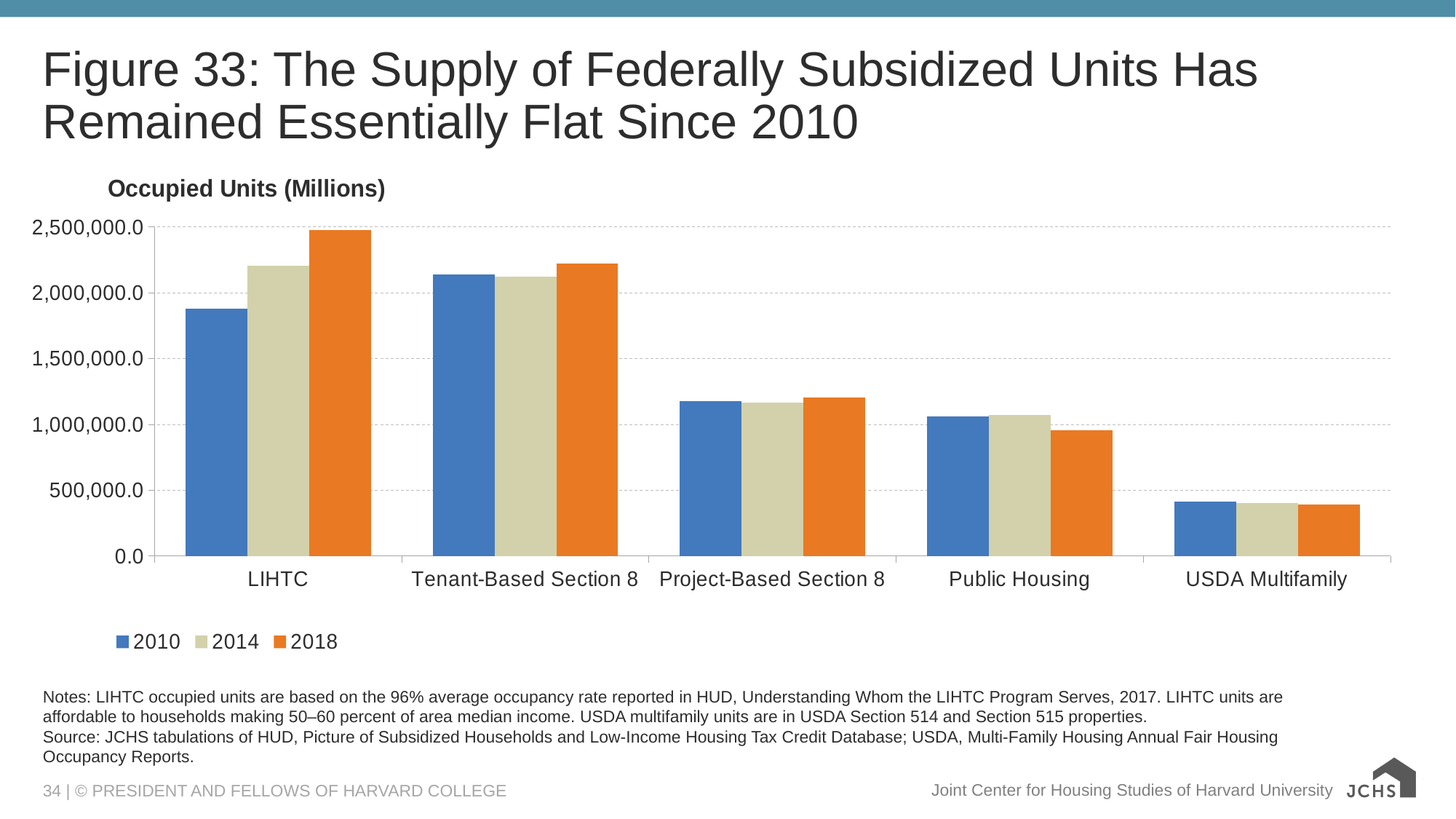
Is the 2010 value for USDA Multifamily greater or less than 500,000.0? less For Public Housing, which year has the larger value: 2010 or 2018? 2010 Which category has the lowest value for 2010? USDA Multifamily Is the 2010 value for LIHTC greater or less than 2,000,000.0? less How many series does the legend list? 3 Do the LIHTC values rise or fall from 2010 to 2018? rise Is the 2018 value for LIHTC greater or less than 2,000,000.0? greater Which is larger for 2018: LIHTC or Tenant-Based Section 8? LIHTC How many program categories are shown on the x axis? 5 Which category has the highest value for 2018? LIHTC What kind of chart is shown on the slide? Bar chart